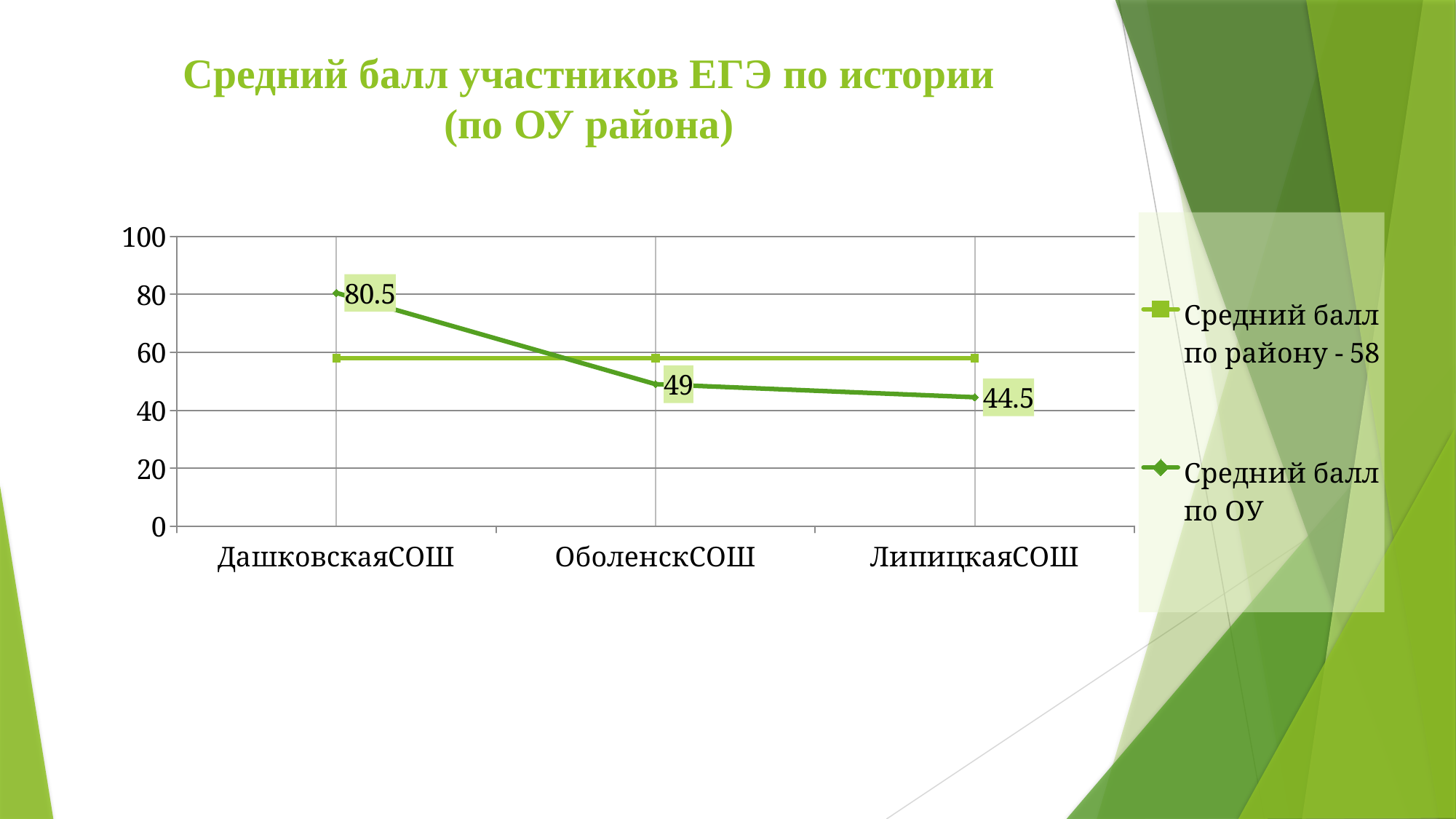
Which school has the lowest average score in the Средний балл по ОУ series? ЛипицкаяСОШ What is the average score (Средний балл по ОУ) for ДашковскаяСОШ? 80.5 Which school has a higher average score, ОболенскСОШ or ЛипицкаяСОШ? ОболенскСОШ What is the difference between the average scores of ДашковскаяСОШ and ЛипицкаяСОШ? 36 What is the difference between the average scores of ОболенскСОШ and ЛипицкаяСОШ? 4.5 Is the average score for ДашковскаяСОШ greater or less than the district average of 58? greater Which school has the highest average score in the Средний балл по ОУ series? ДашковскаяСОШ What is the average score (Средний балл по ОУ) for ЛипицкаяСОШ? 44.5 What is the average score (Средний балл по ОУ) for ОболенскСОШ? 49 Does the Средний балл по ОУ series rise or fall from ДашковскаяСОШ to ЛипицкаяСОШ? fall How many schools are shown on the x axis of the chart? 3 How many series does the chart legend list? 2